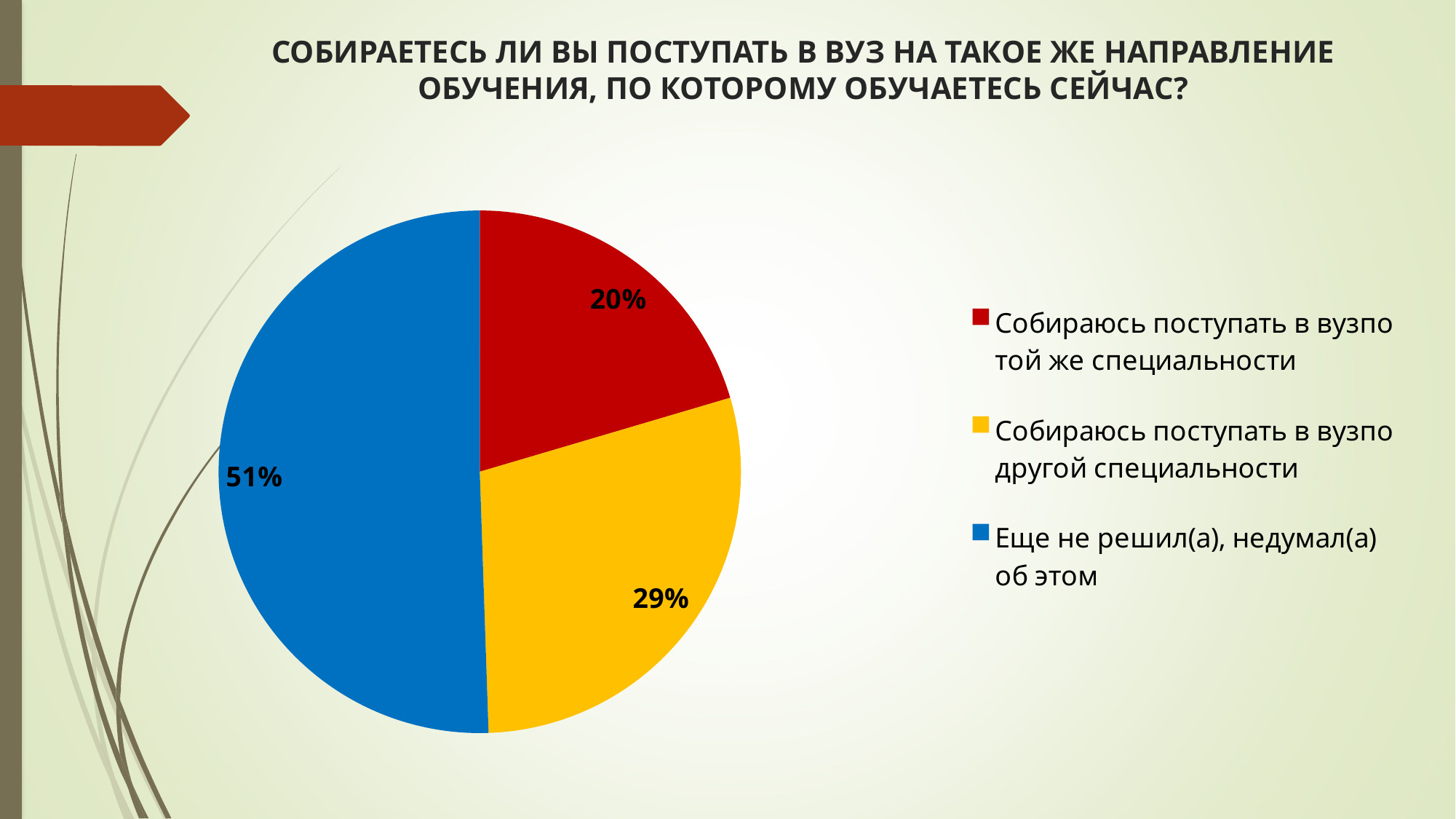
How many slices does the pie chart have? 3 What is the difference in percentage points between the "Еще не решил(а), не думал(а) об этом" slice and the "Собираюсь поступать в вуз по другой специальности" slice? 22 Which category has the smallest slice of the pie? Собираюсь поступать в вуз по той же специальности Which category has the largest slice of the pie? Еще не решил(а), не думал(а) об этом What colour is the slice for "Еще не решил(а), не думал(а) об этом"? blue What colour is the slice for "Собираюсь поступать в вуз по той же специальности"? red What share of the pie is labelled for "Собираюсь поступать в вуз по той же специальности"? 20% What kind of chart is shown on the slide? pie chart Which is larger: the slice for "Собираюсь поступать в вуз по другой специальности" or the slice for "Собираюсь поступать в вуз по той же специальности"? Собираюсь поступать в вуз по другой специальности What share of the pie is labelled for "Собираюсь поступать в вуз по другой специальности"? 29% How many entries does the legend list? 3 What share of the pie is labelled for "Еще не решил(а), не думал(а) об этом"? 51%